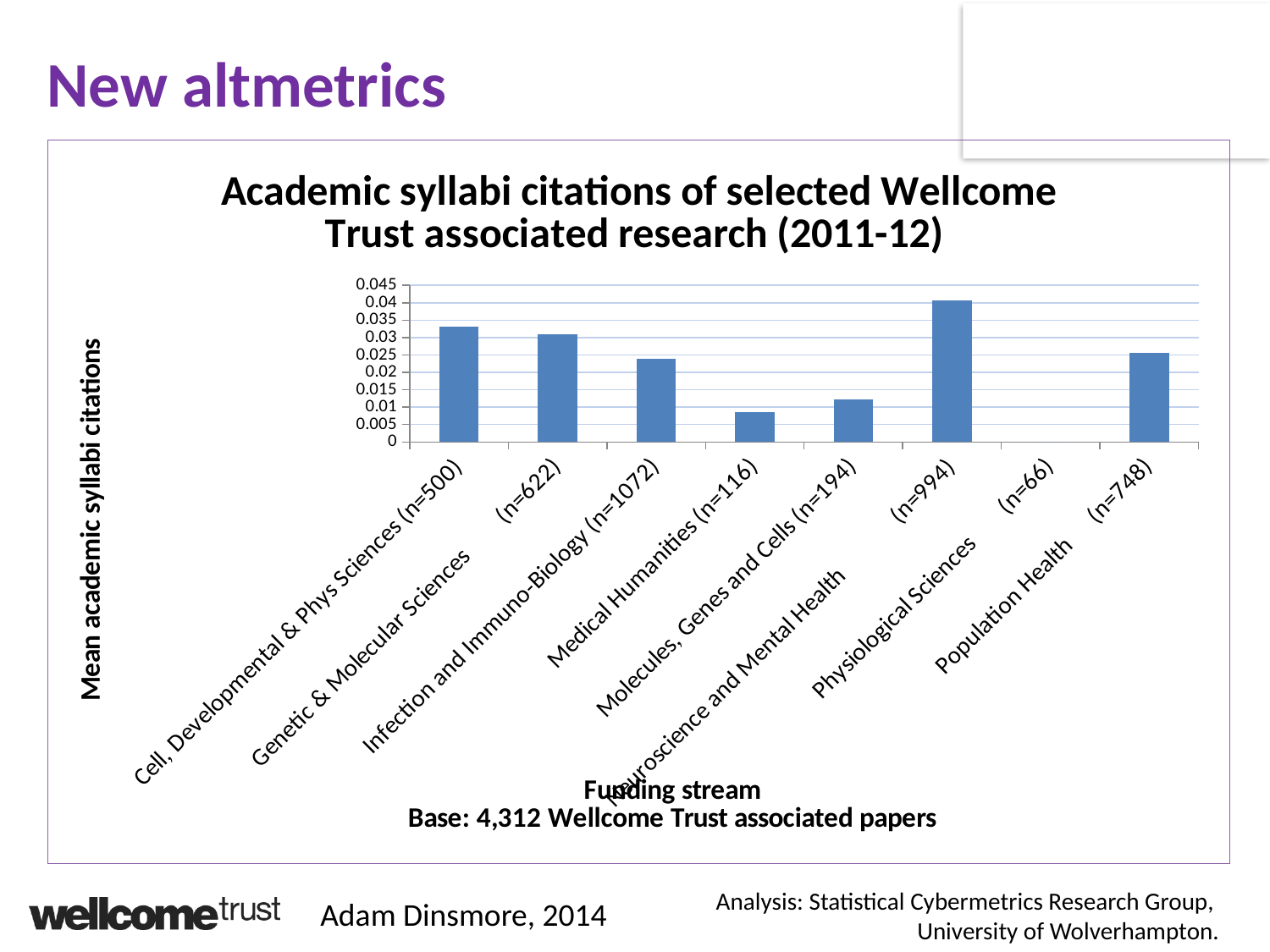
Which funding stream shows no visible bar (the lowest value)? Physiological Sciences (n=66) What kind of chart is shown on the slide? Bar chart What is the label of the y axis? Mean academic syllabi citations What is the title of the chart? Academic syllabi citations of selected Wellcome Trust associated research (2011-12) Is the value for Medical Humanities greater or less than 0.015? less Is the value for Population Health greater or less than 0.02? greater Which has a higher value: Neuroscience and Mental Health or Population Health? Neuroscience and Mental Health How many funding stream categories are shown on the x axis? 8 Is the value for Cell, Developmental & Phys Sciences greater or less than 0.03? greater Which funding stream has the highest mean academic syllabi citations? Neuroscience and Mental Health (n=994)